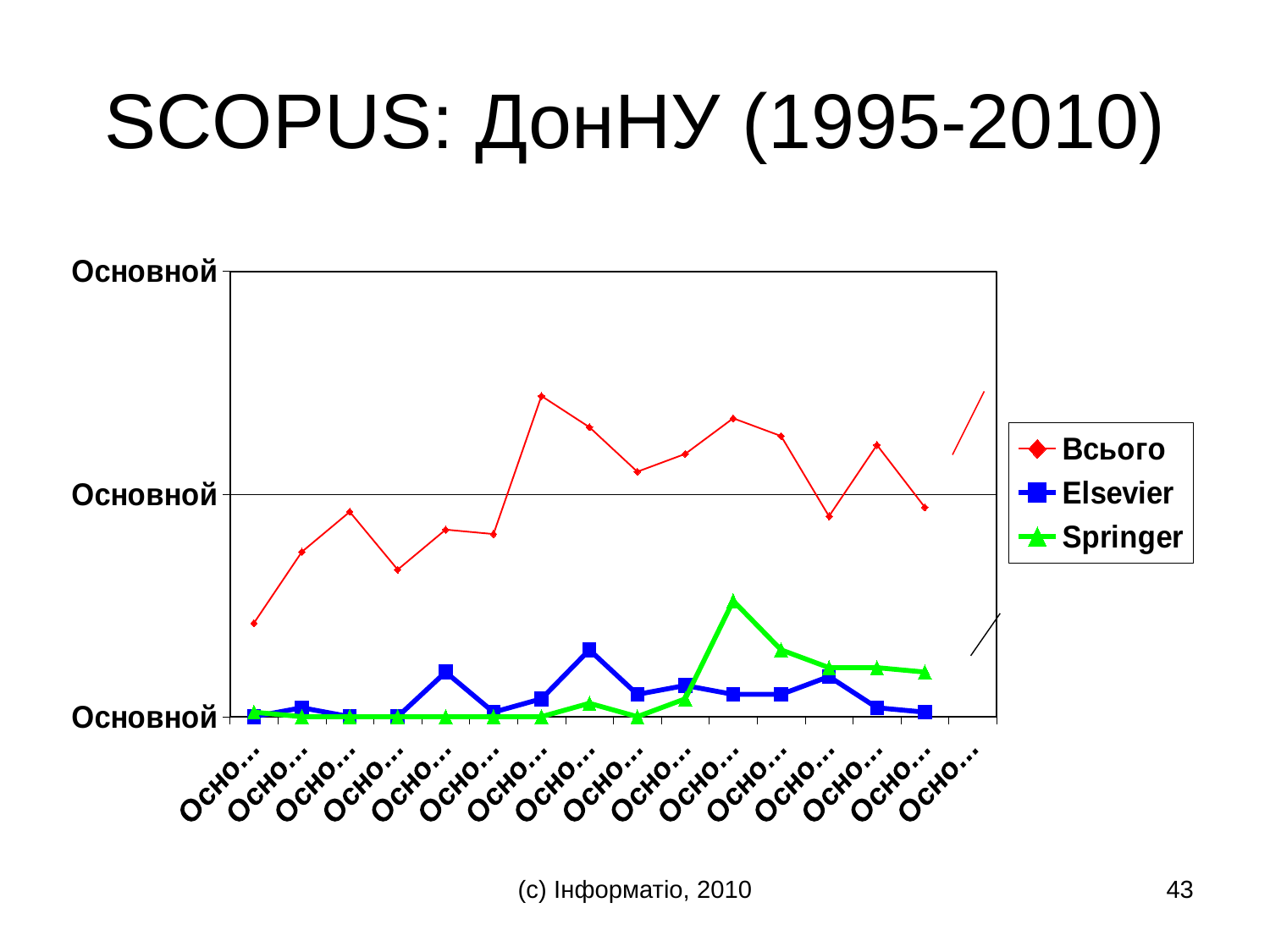
What is the title of the slide containing the chart? SCOPUS: ДонНУ (1995-2010) Which series reaches the highest single peak among Elsevier and Springer? Springer Which series has the highest values across the chart? Всього At the last point on the x axis, which is larger: Elsevier or Springer? Springer What kind of chart is shown on the slide? line chart Does the Всього series end higher or lower than it starts? higher Which series are listed in the legend? Всього, Elsevier, Springer How many series does the legend list? 3 How many data points does each series have along the x axis? 15